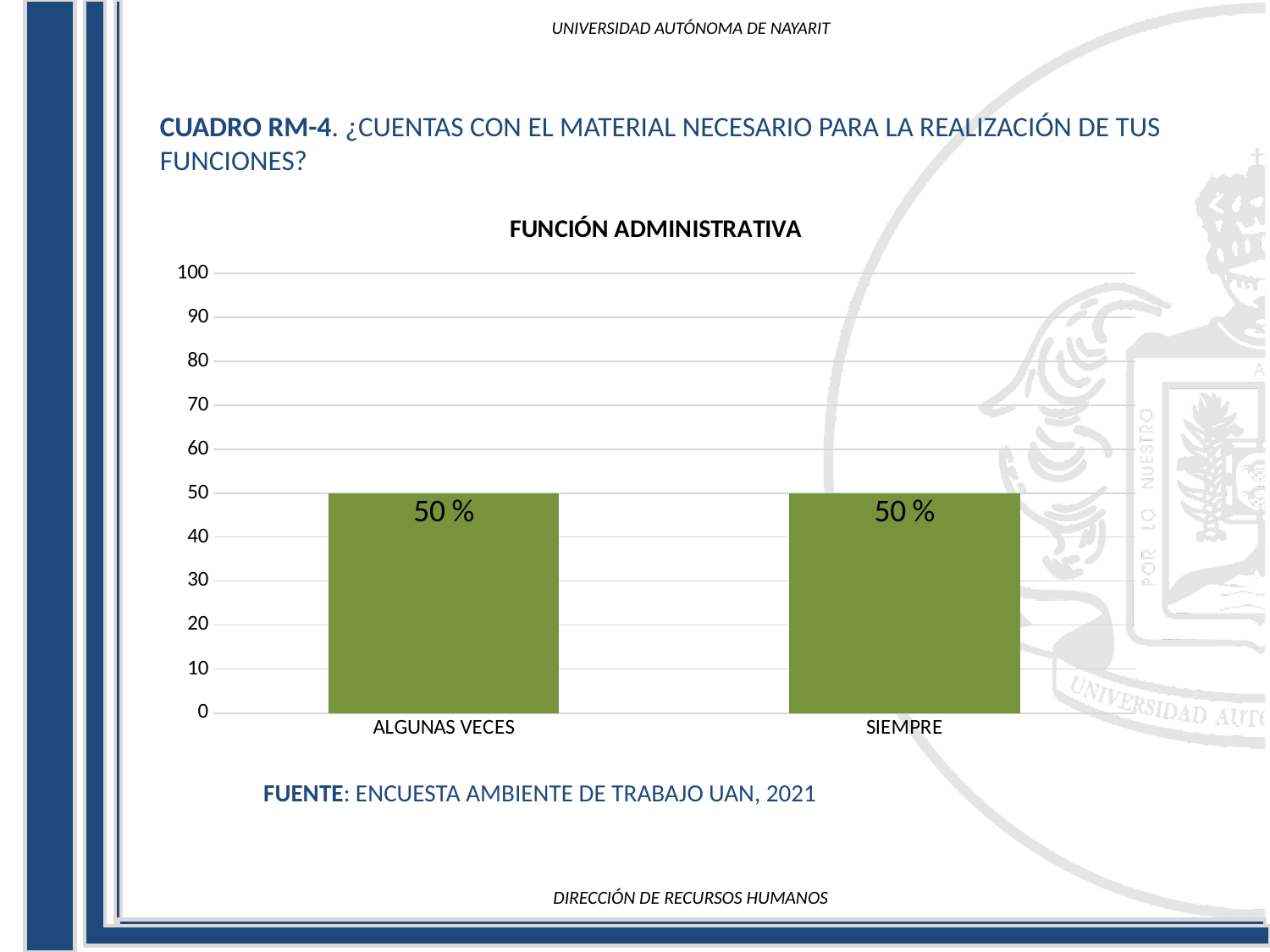
What kind of chart is shown on the slide? bar chart What is the difference between the values for ALGUNAS VECES and SIEMPRE? 0 What is the value for SIEMPRE? 50 % How many categories are shown on the x axis? 2 What is the total of the values for ALGUNAS VECES and SIEMPRE? 100 % Is the value for SIEMPRE greater or less than 80? less What is the value for ALGUNAS VECES? 50 % What is the highest value shown on the vertical axis? 100 What is the title of the chart? FUNCIÓN ADMINISTRATIVA Is the value for ALGUNAS VECES greater or less than 20? greater